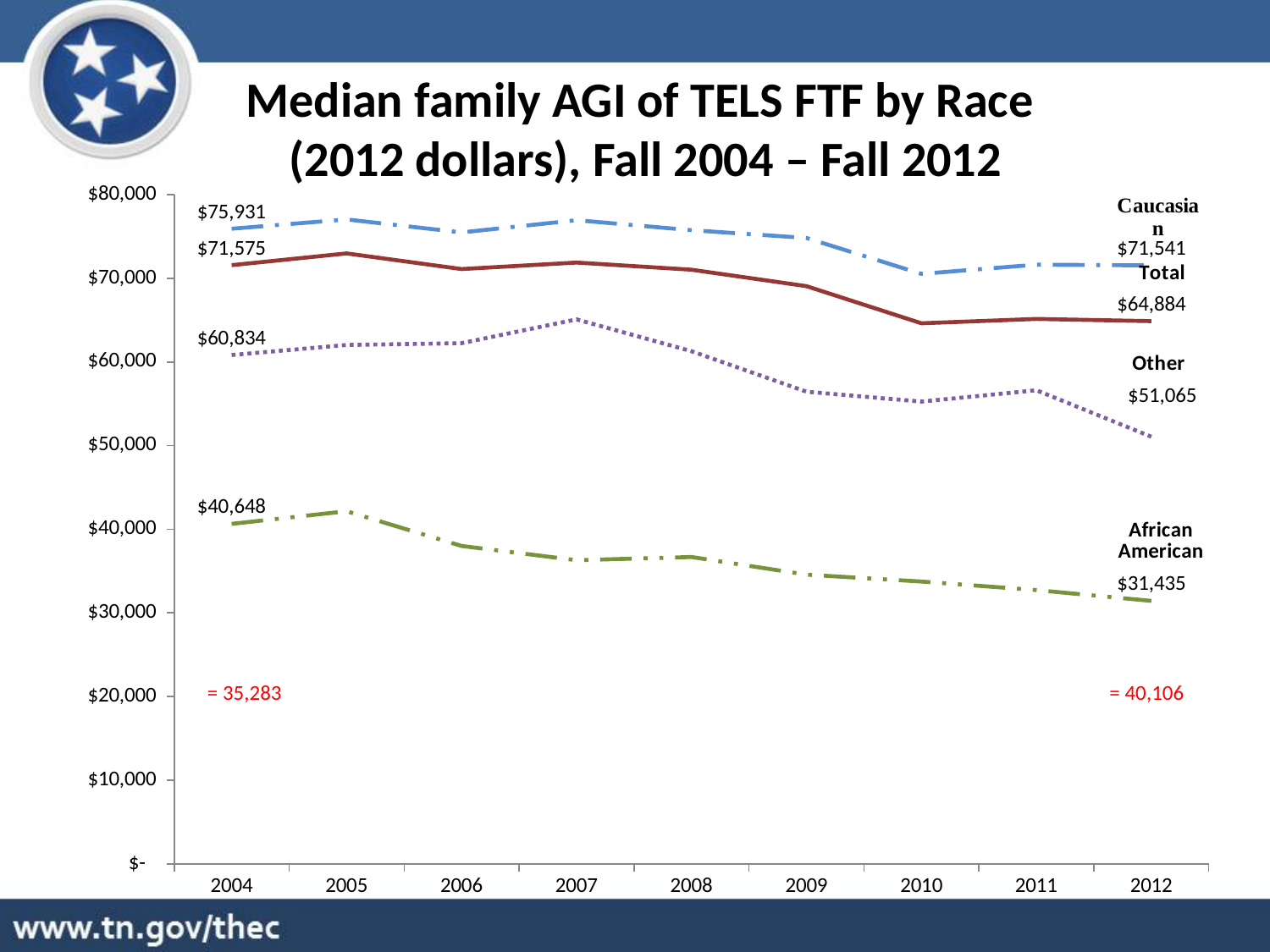
How many years are shown on the x axis? 9 What is the median family AGI for Caucasian students in 2004? $75,931 Does the median family AGI for African American students rise or fall from 2004 to 2012? fall What is the median family AGI for African American students in 2012? $31,435 Is the median family AGI for the Other group in 2009 greater or less than $60,000? less By how much did the Caucasian median family AGI decrease between 2004 and 2012? $4,390 By how much did the median family AGI for African American students fall from 2004 to 2012? $9,213 Which group has the lowest median family AGI in 2004? African American What is the median family AGI for the Other group in 2004? $60,834 What is the Total median family AGI in 2012? $64,884 What kind of chart is shown on the slide? line chart Which group has the highest median family AGI in 2012? Caucasian